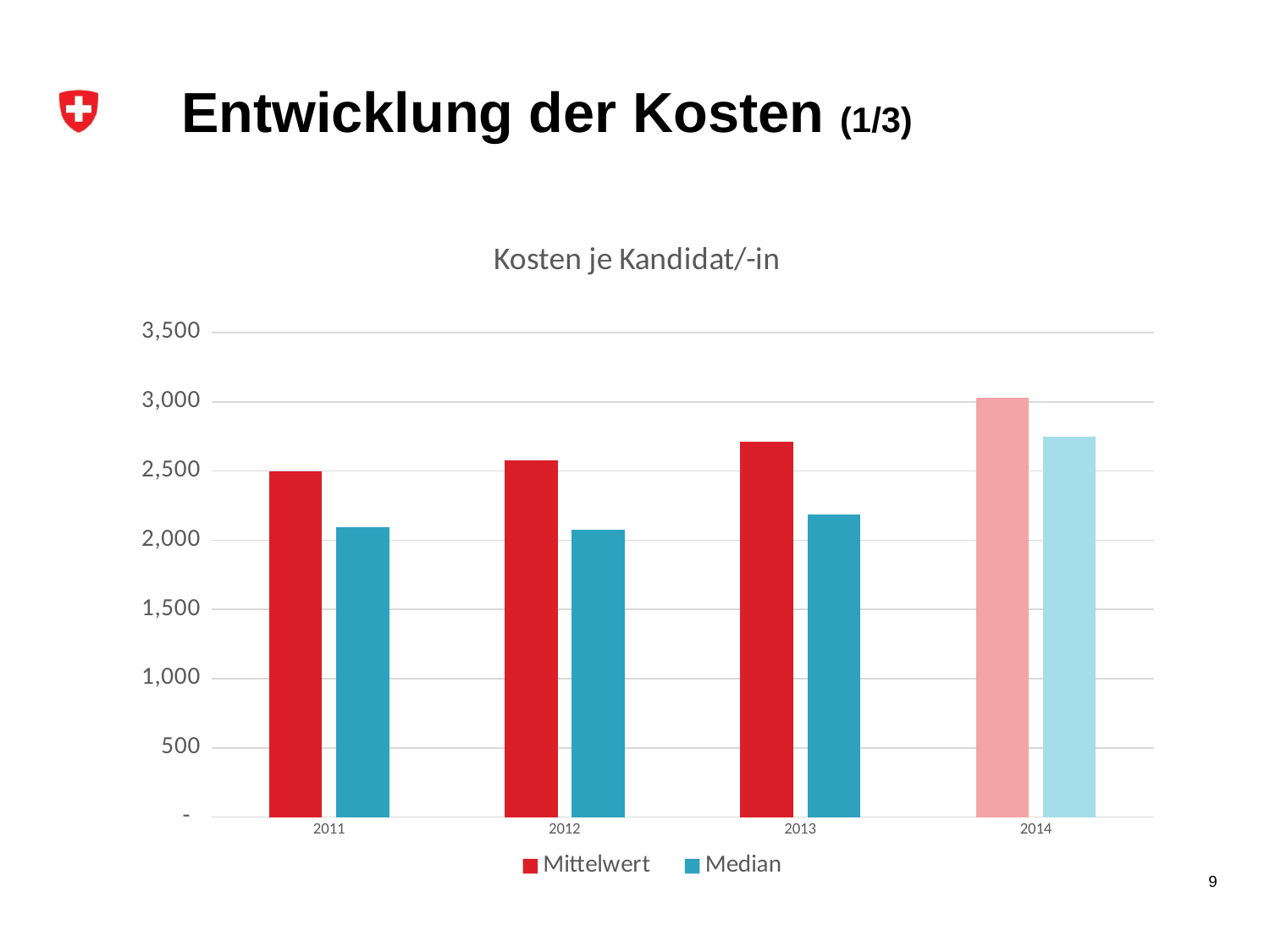
How many years are shown on the x axis? 4 Is the Mittelwert value for 2013 greater or less than 2,500? greater What is the title of the chart? Kosten je Kandidat/-in Is the Median value for 2014 greater or less than 2,500? greater In 2014, which is larger, the Mittelwert or the Median? Mittelwert How many series does the legend list? 2 In which year is the Median highest? 2014 Does the Mittelwert rise or fall from 2011 to 2014? rise Is the Median value for 2012 greater or less than 2,000? greater What type of chart is shown on the slide? Bar chart Which series is shown in red? Mittelwert In which year is the Mittelwert highest? 2014